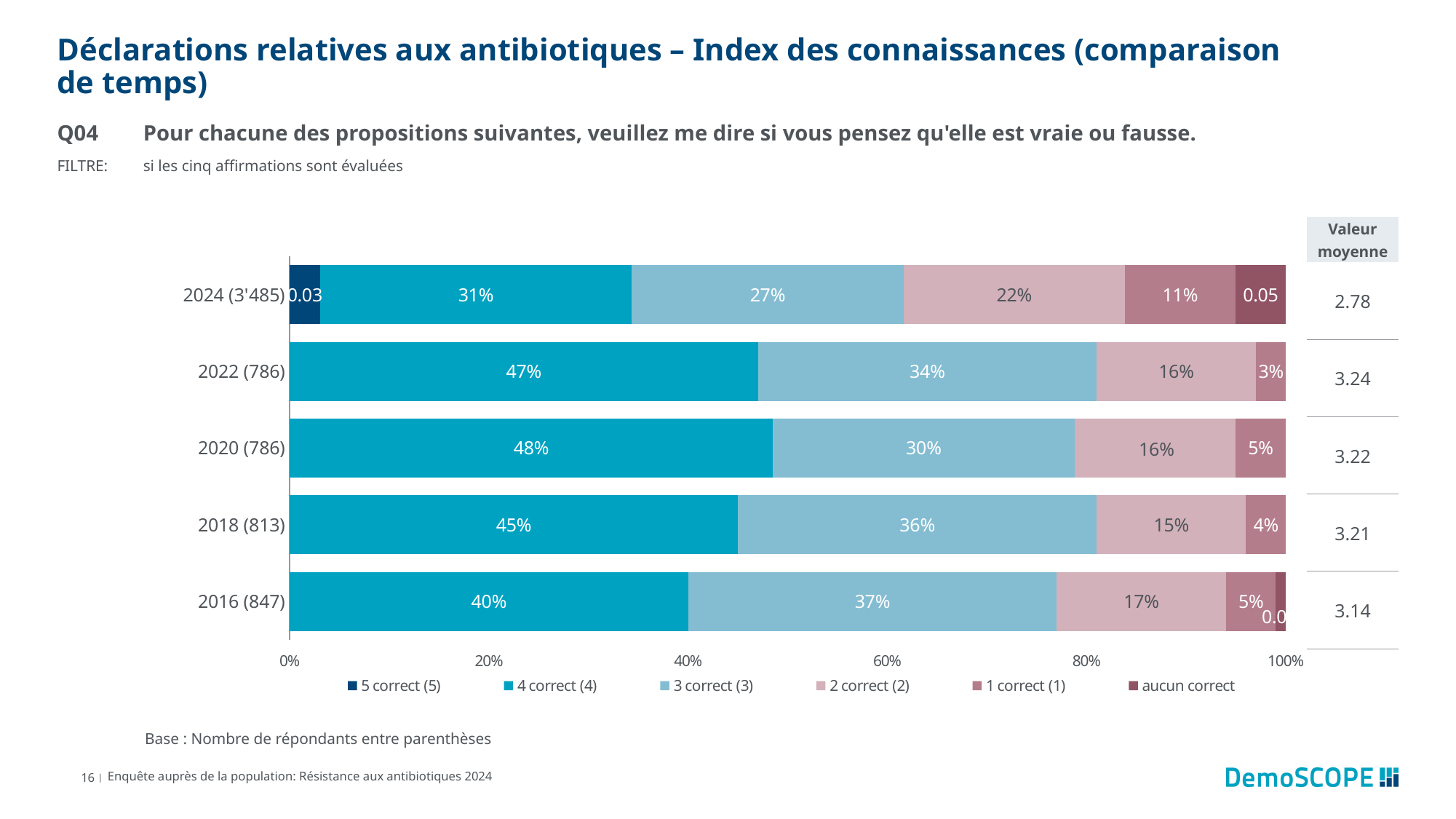
What is the value for '1 correct (1)' in 2020 (786)? 5% Which is larger: the '2 correct (2)' value for 2016 (847) or for 2018 (813)? 2016 (847) Which year has the lowest value for '4 correct (4)'? 2024 (3'485) What is the difference between the '3 correct (3)' values for 2018 (813) and 2024 (3'485)? 9% What is the value for '2 correct (2)' in 2024 (3'485)? 22% How many series does the legend list? 6 Which year has the highest value for '4 correct (4)'? 2020 (786) What is the value for '3 correct (3)' in 2016 (847)? 37% How many year categories are plotted on the chart? 5 What kind of chart is shown on the slide? stacked bar chart What is the 'Valeur moyenne' shown for 2022 (786)? 3.24 What is the value for '4 correct (4)' in 2022 (786)? 47%